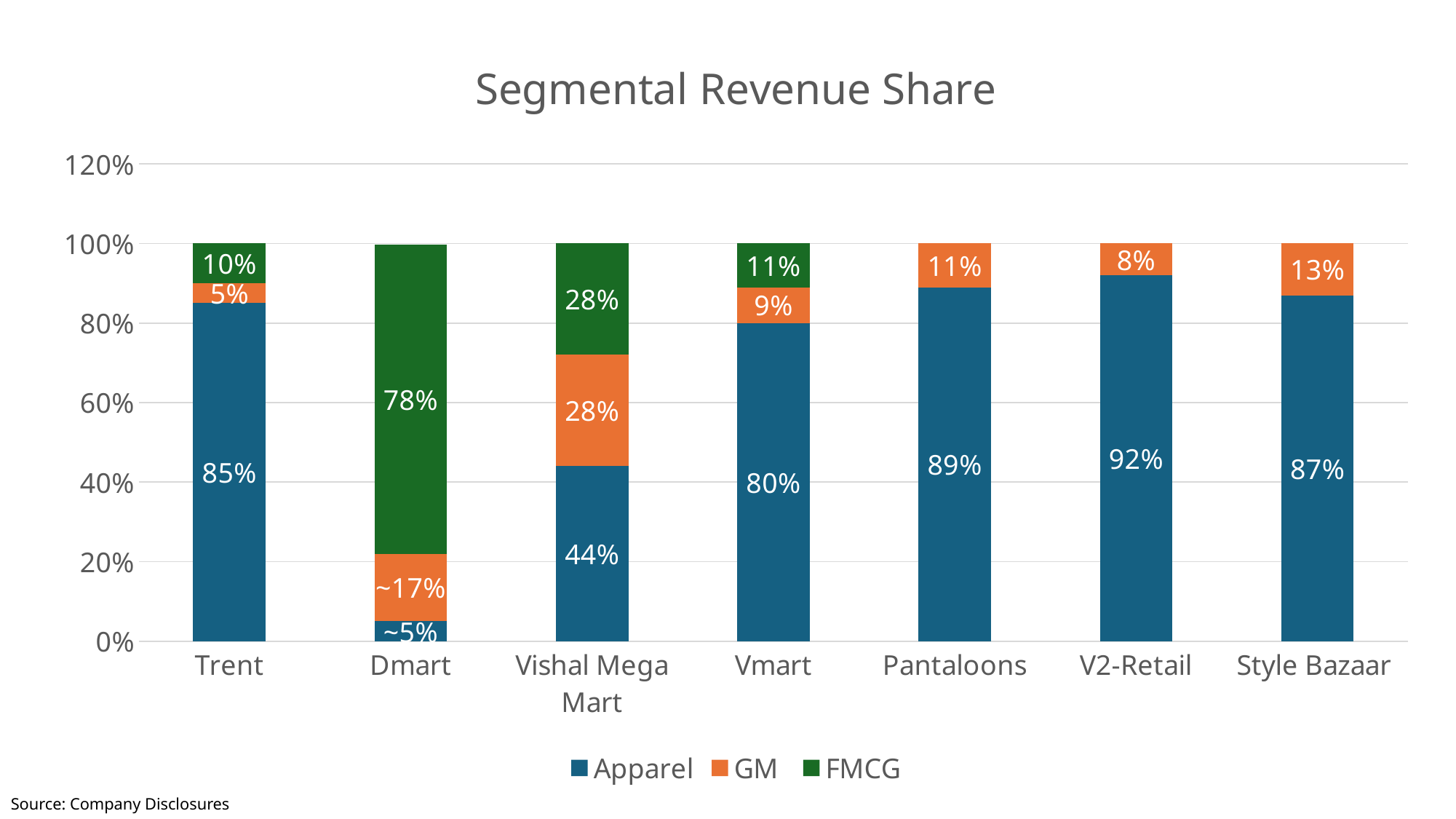
Which company has the highest Apparel revenue share? V2-Retail What is the GM revenue share for Style Bazaar? 13% How many percentage points higher is Trent's Apparel share than Vmart's Apparel share? 5 percentage points What kind of chart is shown on the slide? Stacked bar chart Which company has the lowest Apparel revenue share? Dmart What is the Apparel revenue share for Vishal Mega Mart? 44% What is the FMCG revenue share for Dmart? 78% What is the title of the chart? Segmental Revenue Share Which has a larger GM revenue share, Vishal Mega Mart or Vmart? Vishal Mega Mart What is the Apparel revenue share for V2-Retail? 92% How many companies are shown on the x axis? 7 How many series does the legend list? 3